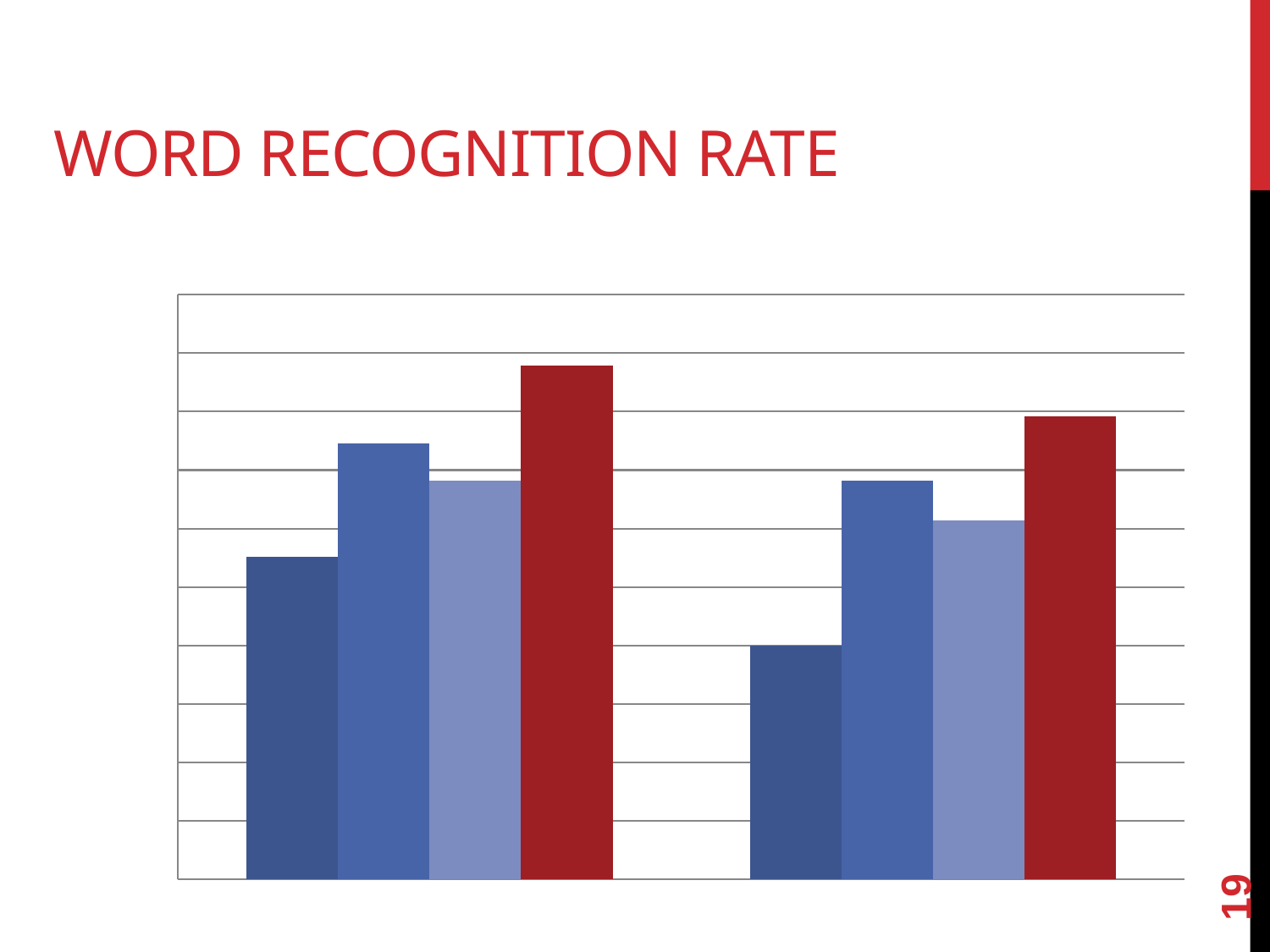
How many bars are plotted in total on the chart? 8 In the right group of bars, which bar is the tallest? the red bar (rightmost) How many groups of bars does the chart show? 2 What is the title of the chart on the slide? WORD RECOGNITION RATE How many different bar colours are used in the chart? 4 What kind of chart is shown on the slide? bar chart In the left group of bars, which bar is the shortest? the dark blue bar (leftmost) In the right group of bars, which bar is the shortest? the dark blue bar (leftmost) In the left group of bars, which bar is the tallest? the red bar (rightmost) Is the red bar taller in the left group or in the right group? the left group Is the dark blue bar taller in the left group or in the right group? the left group How many bars are in each group of the chart? 4